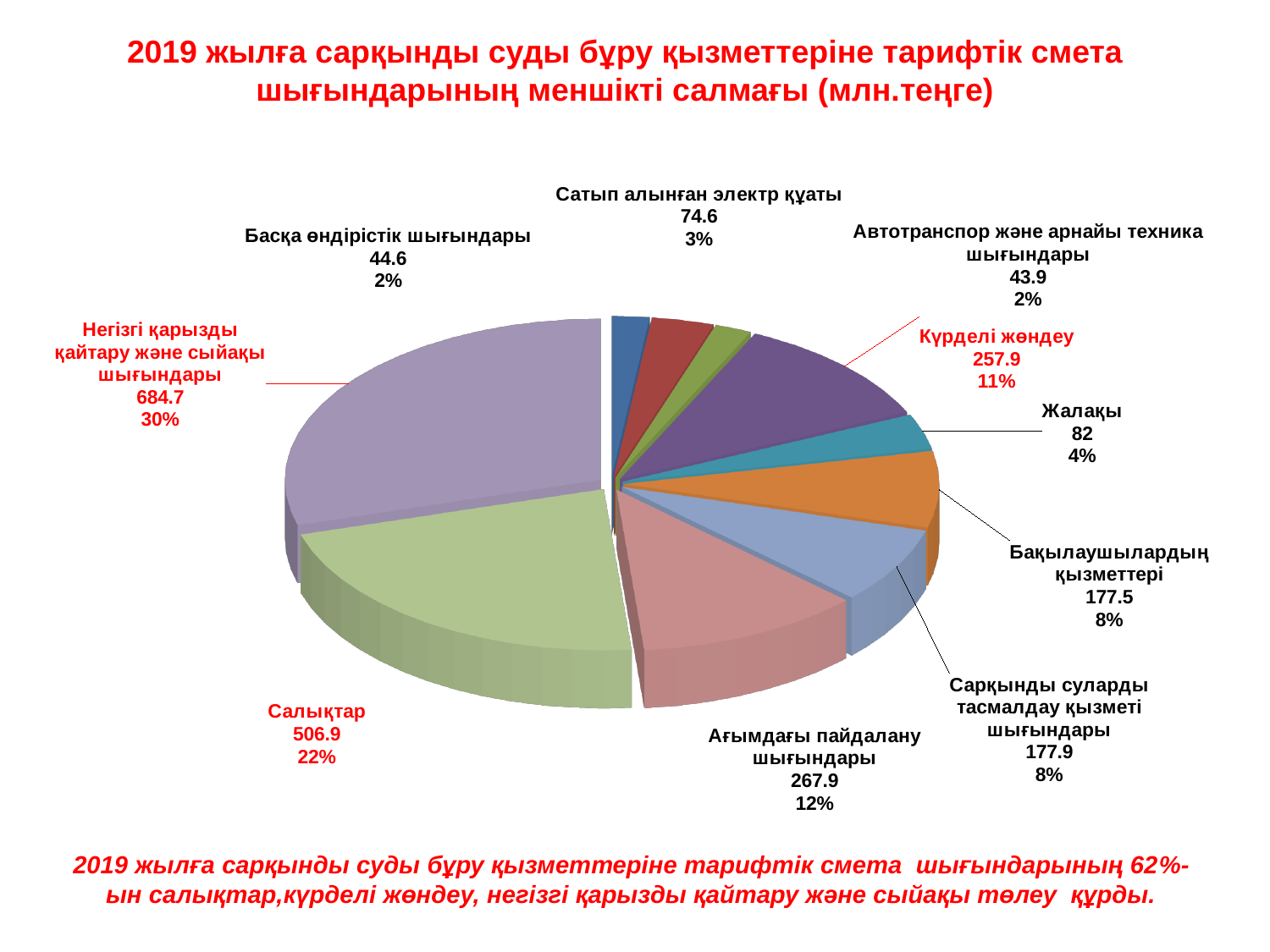
What is the value for Күрделі жөндеу? 257.9 How many slices does the pie chart have? 10 What unit is given in the chart title for the values? млн.теңге Which category has the largest slice of the pie? Негізгі қарызды қайтару және сыйақы шығындары What share of the pie does Негізгі қарызды қайтару және сыйақы шығындары represent? 30% What type of chart is shown on the slide? pie chart What is the value for Салықтар? 506.9 What share of the pie does Ағымдағы пайдалану шығындары represent? 12% Which category has the smallest value in the pie chart? Автотранспор және арнайы техника шығындары Which is larger, the value for Күрделі жөндеу or the value for Ағымдағы пайдалану шығындары? Ағымдағы пайдалану шығындары What is the difference between the values for Негізгі қарызды қайтару және сыйақы шығындары and Салықтар? 177.8 What is the value for Жалақы? 82